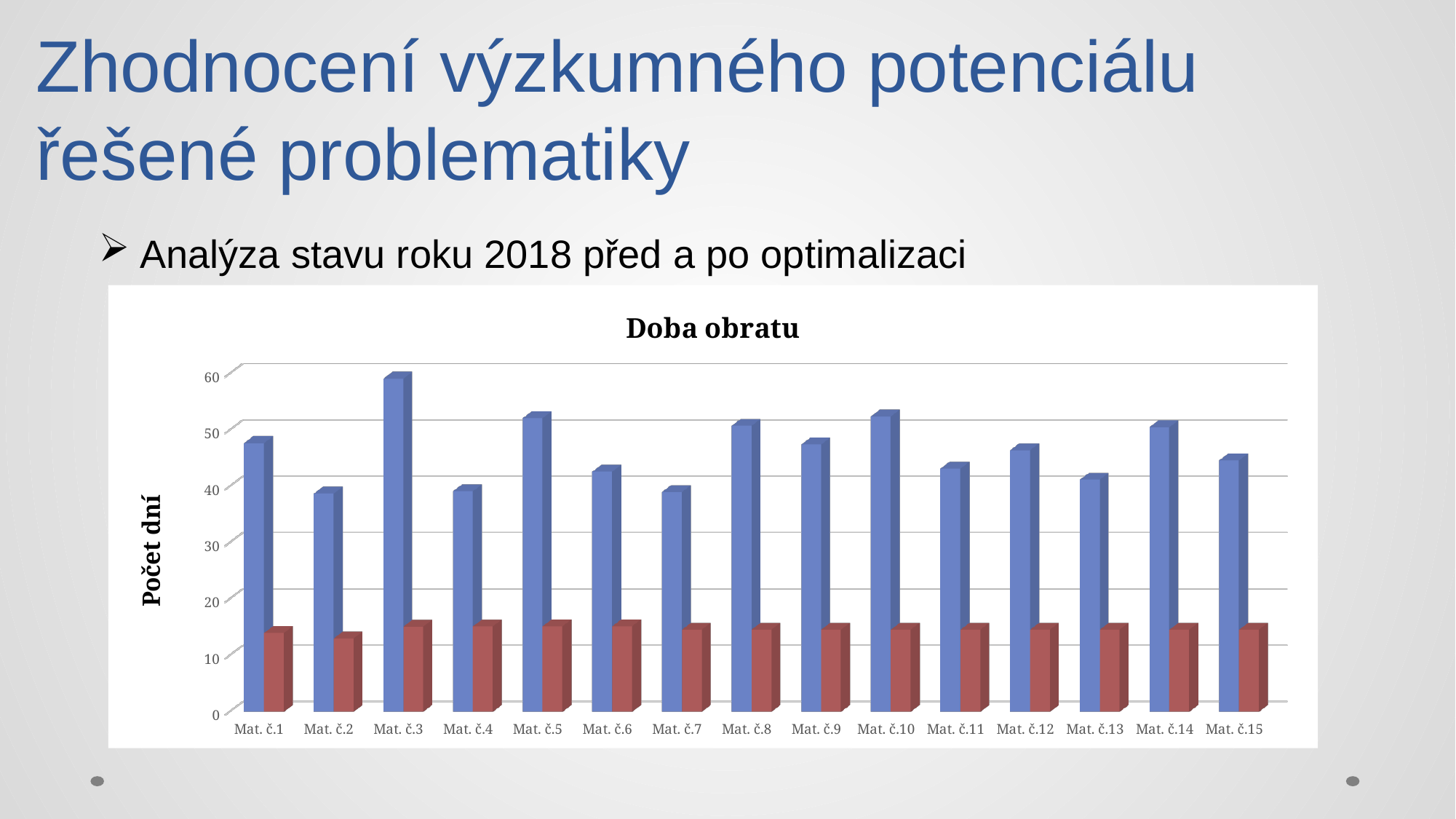
Is the blue bar for Mat. č.3 greater or less than 50? greater What is the label of the vertical axis? Počet dní How many bars are plotted for each category? 2 What type of chart is shown on the slide? bar chart How many categories are shown on the x axis? 15 What is the title of the chart? Doba obratu For Mat. č.1, which bar is larger, the blue one or the red one? the blue one Which category has the highest blue bar? Mat. č.3 Is the red bar for Mat. č.8 greater or less than 20? less Is the blue bar for Mat. č.10 greater or less than 50? greater Which is larger, the blue bar for Mat. č.5 or the blue bar for Mat. č.4? Mat. č.5